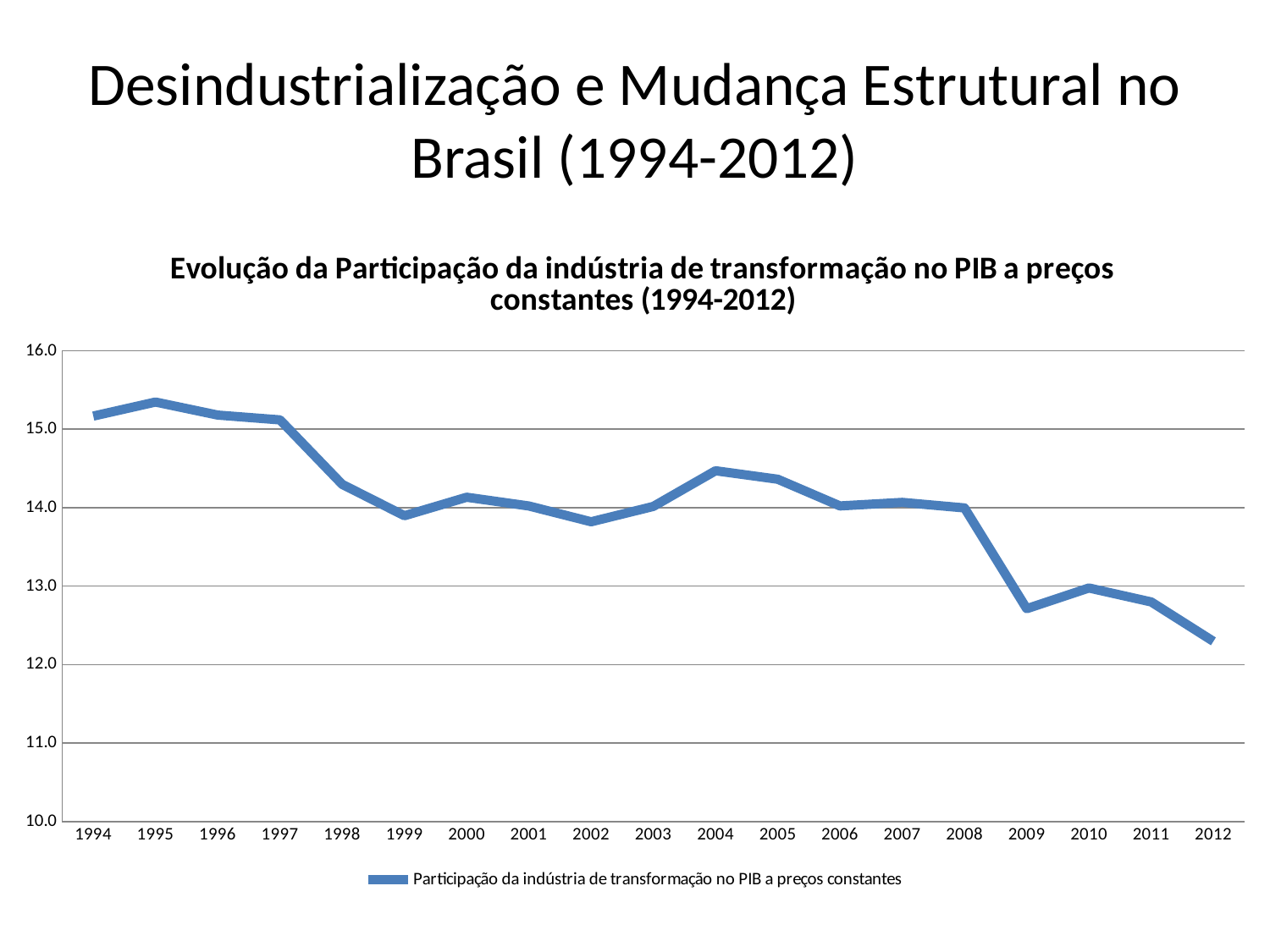
Which year has the highest value? 1995 Which year has the lowest value? 2012 Which is larger, the value for 1997 or the value for 1998? 1997 What is the title of the chart? Evolução da Participação da indústria de transformação no PIB a preços constantes (1994-2012) Is the value for 2009 greater or less than 13.0? less How many series does the legend list? 1 Is the value for 2012 greater or less than 13.0? less Is the value for 2004 greater or less than 14.0? greater Overall, do the values rise or fall from 1994 to 2012? fall What kind of chart is shown on the slide? line chart How many years are plotted along the x axis? 19